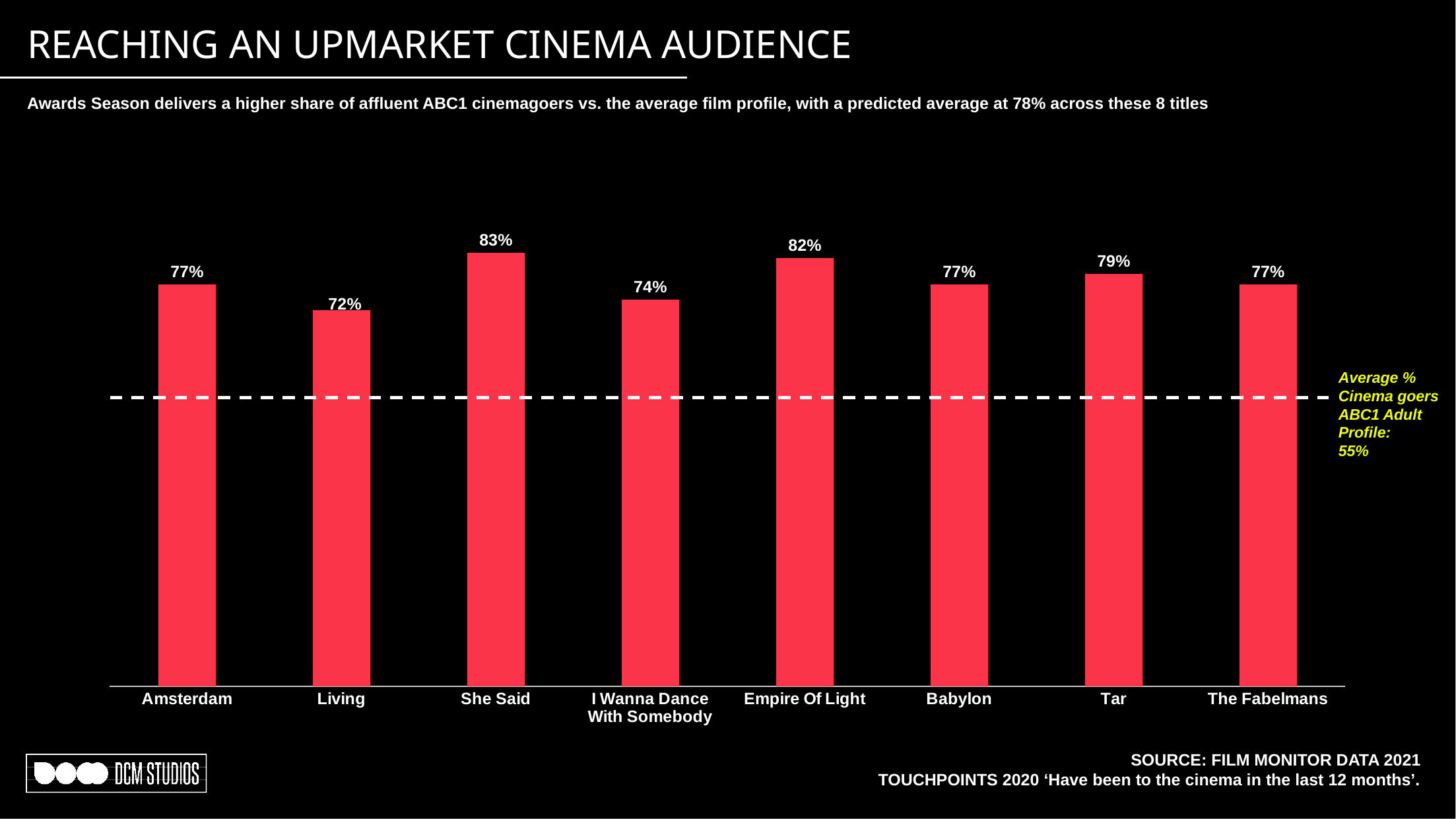
What is the value for Living? 72% Which title has the highest value? She Said What is the difference between the values for She Said and Living? 11% Which title has the lowest value? Living Which is larger, the value for Tar or the value for I Wanna Dance With Somebody? Tar What colour are the bars on the chart? Red What is the value for Tar? 79% What value does the dashed line labelled Average % Cinema goers ABC1 Adult Profile represent? 55% What is the value for Empire Of Light? 82% What is the value for She Said? 83% How many titles are shown on the chart? 8 What kind of chart is shown on the slide? Bar chart